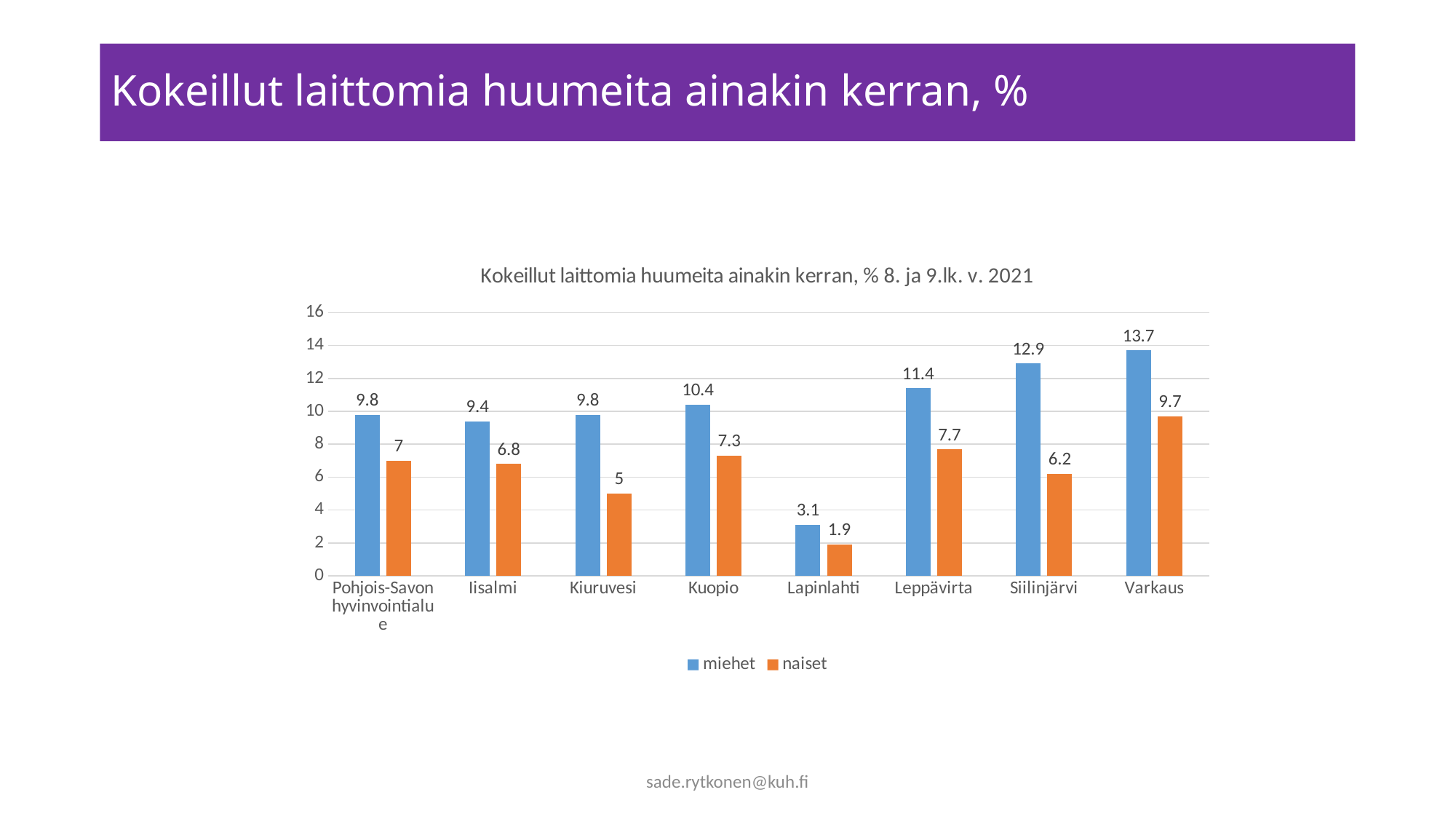
What kind of chart is shown on the slide? bar chart Which category has the highest value for miehet? Varkaus What is the value for naiset in Siilinjärvi? 6.2 What is the value for miehet in Kuopio? 10.4 How many series does the legend list? 2 Which is larger: the naiset value in Leppävirta or the naiset value in Kuopio? Leppävirta Which category has the lowest value for naiset? Lapinlahti What is the value for naiset in Lapinlahti? 1.9 What are the two series listed in the legend? miehet and naiset What is the difference between the miehet and naiset values in Varkaus? 4 Is the value for miehet in Siilinjärvi greater or less than 12? greater How many categories are shown on the x axis? 8